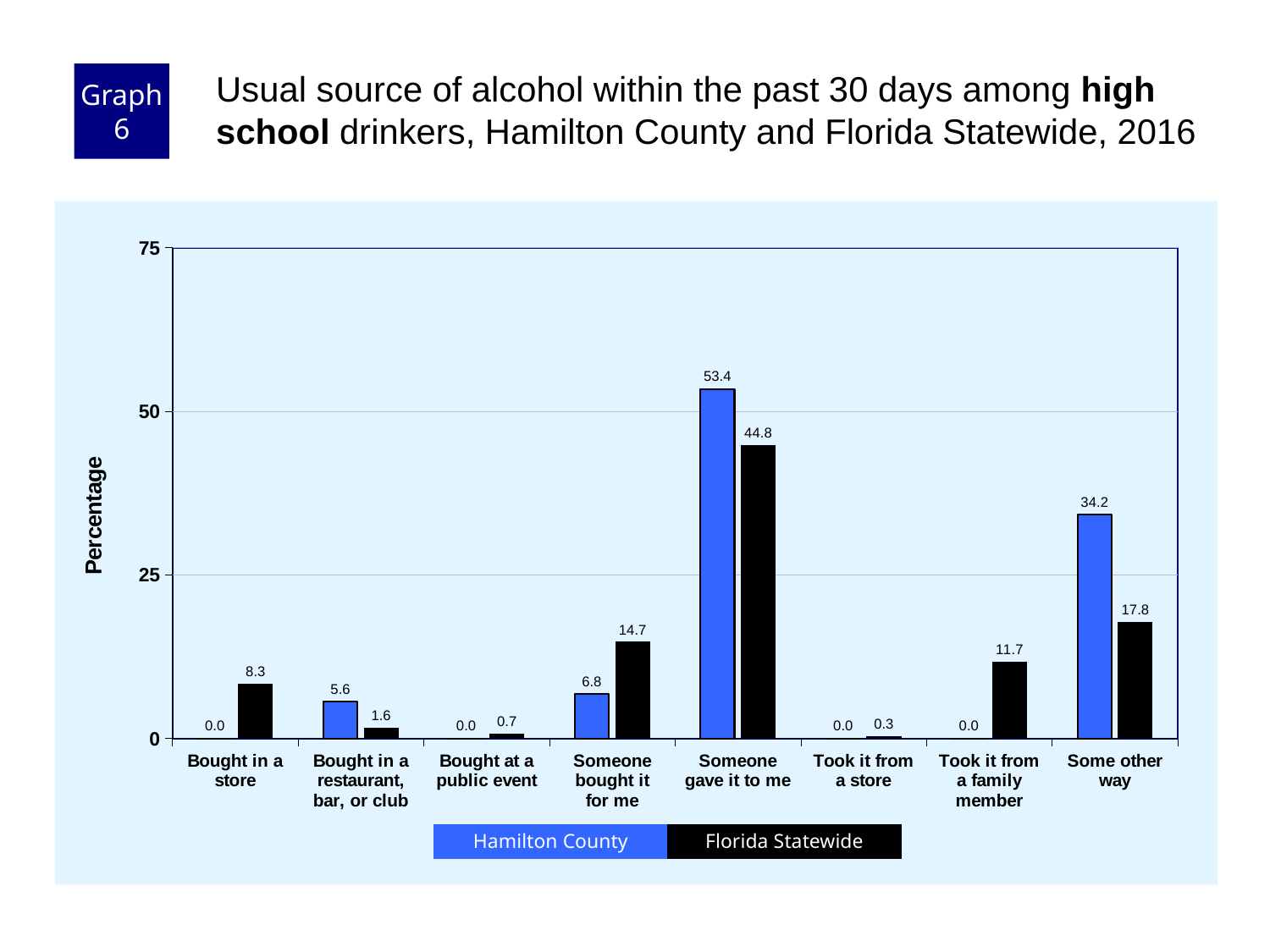
For "Someone bought it for me", which is larger: Hamilton County or Florida Statewide? Florida Statewide How many series does the legend list? 2 What is the difference between the Hamilton County and Florida Statewide values for "Some other way"? 16.4 What is the difference between the Hamilton County and Florida Statewide values for "Someone gave it to me"? 8.6 What is the Hamilton County value for "Someone gave it to me"? 53.4 Which category has the lowest Florida Statewide value? Took it from a store How many source categories are shown on the x axis? 8 What is the Hamilton County value for "Some other way"? 34.2 What kind of chart is shown on the slide? Bar chart Which category has the highest Florida Statewide value? Someone gave it to me What is the Florida Statewide value for "Took it from a family member"? 11.7 Which colour represents Hamilton County in the chart? Blue